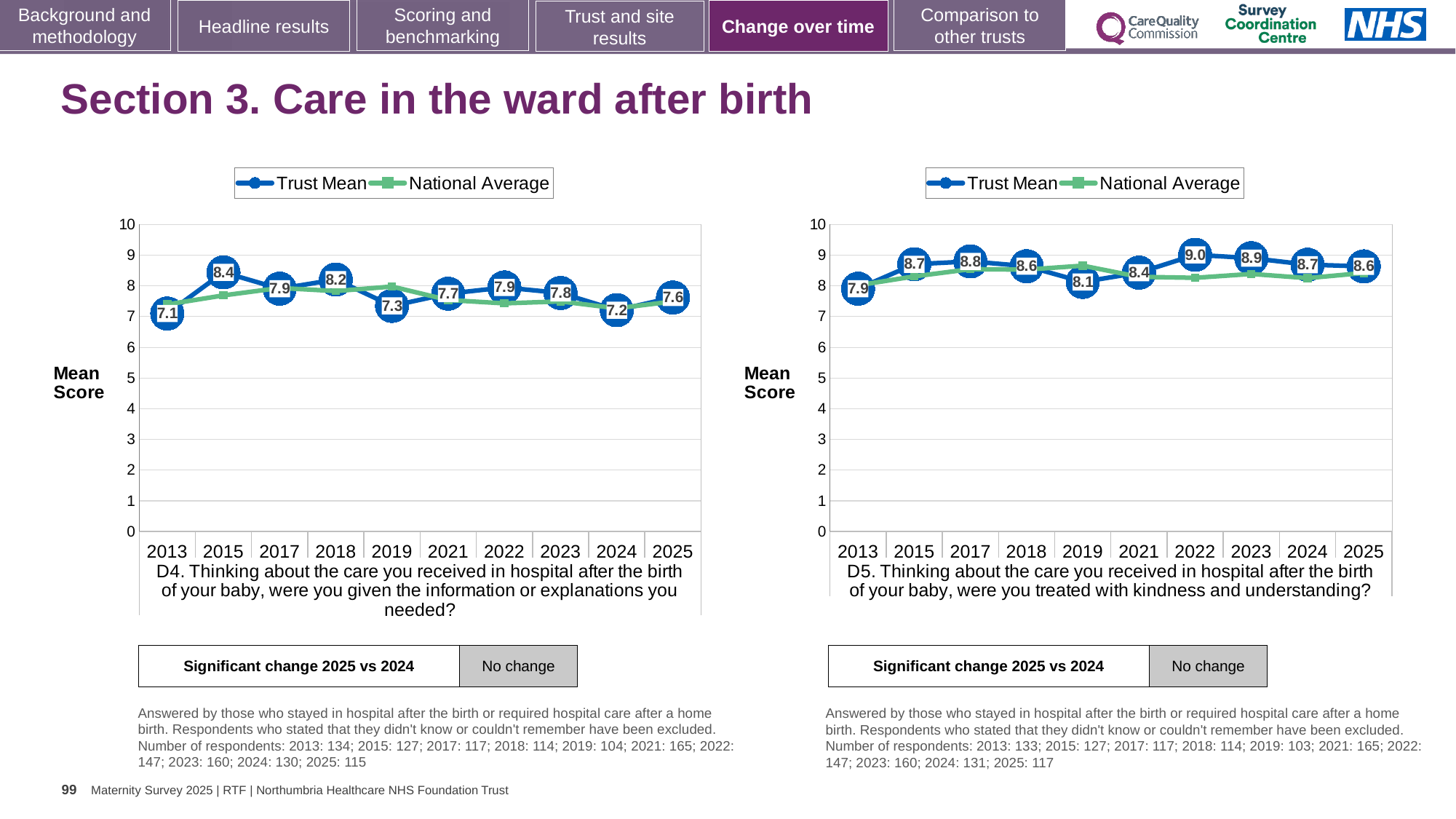
In the D5 chart on the right, what is the Trust Mean score for 2022? 9.0 In the D4 chart on the left, what is the Trust Mean score for 2013? 7.1 In the D4 chart on the left, what is the difference between the Trust Mean scores for 2015 and 2024? 1.2 In the D5 chart on the right, which year has the lowest Trust Mean score? 2013 In the D4 chart on the left, which year has the lowest Trust Mean score? 2013 What type of chart is the D4 chart on the left? Line chart In the D4 chart on the left, what is the Trust Mean score for 2025? 7.6 In the D5 chart on the right, what is the difference between the Trust Mean scores for 2022 and 2025? 0.4 How many years are plotted on the x axis of the D5 chart on the right? 10 In the D4 chart on the left, which year has the highest Trust Mean score? 2015 How many series does the legend of the D4 chart on the left list? 2 In the D5 chart on the right, which is larger, the Trust Mean score for 2019 or for 2021? 2021